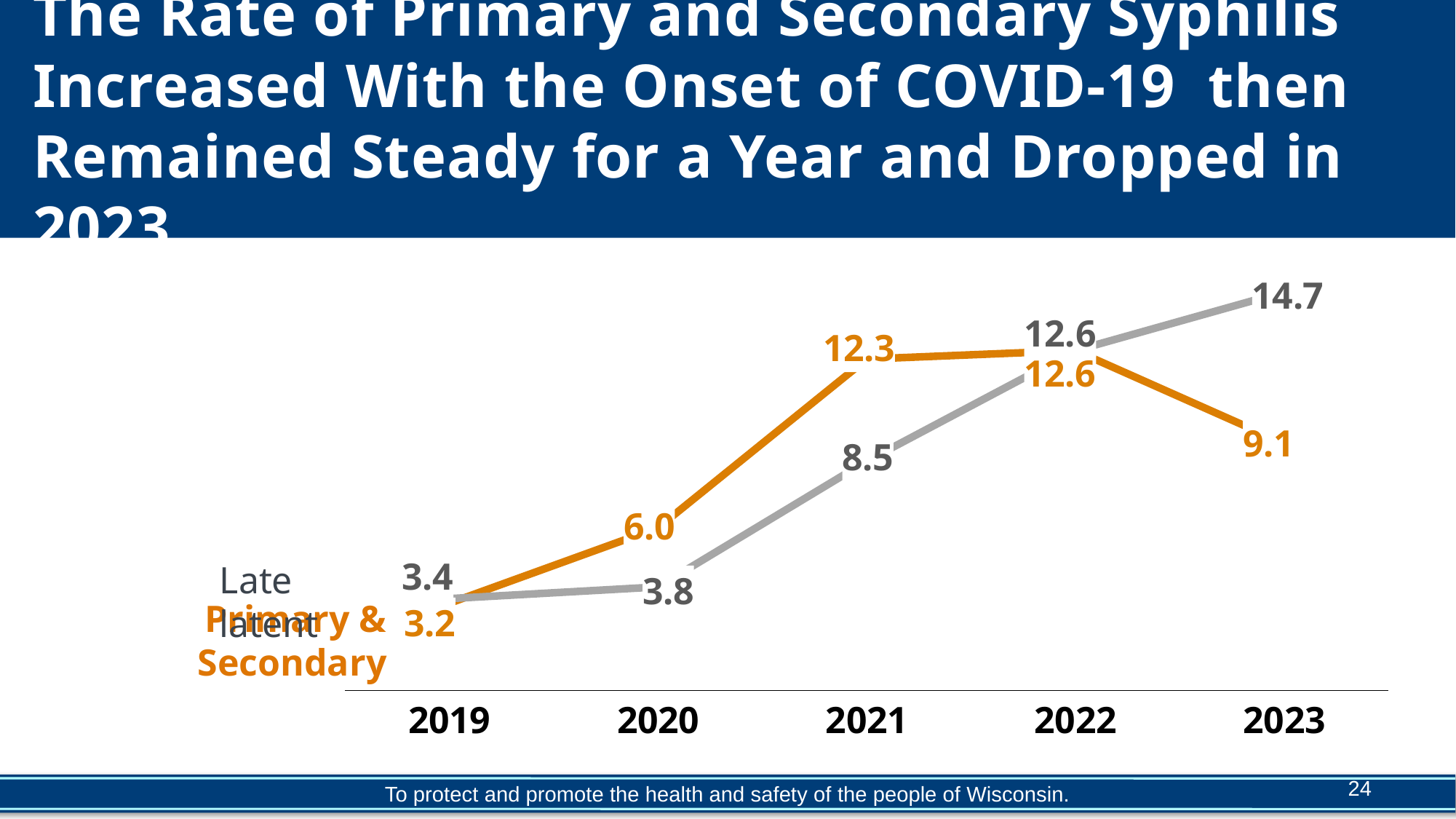
What is the difference between the Late latent rate in 2023 and the Primary & Secondary rate in 2023? 5.6 What is the Late latent syphilis rate in 2023? 14.7 How many series are plotted on the chart? 2 What is the Primary & Secondary syphilis rate in 2021? 12.3 Does the Late latent rate rise or fall from 2019 to 2023? rise In which year is the Primary & Secondary rate highest? 2022 How many years are shown on the x axis? 5 What is the Primary & Secondary syphilis rate in 2023? 9.1 What kind of chart is shown on the slide? line chart Which series has the higher rate in 2021, Primary & Secondary or Late latent? Primary & Secondary In which year is the Late latent rate lowest? 2019 What is the Late latent syphilis rate in 2020? 3.8